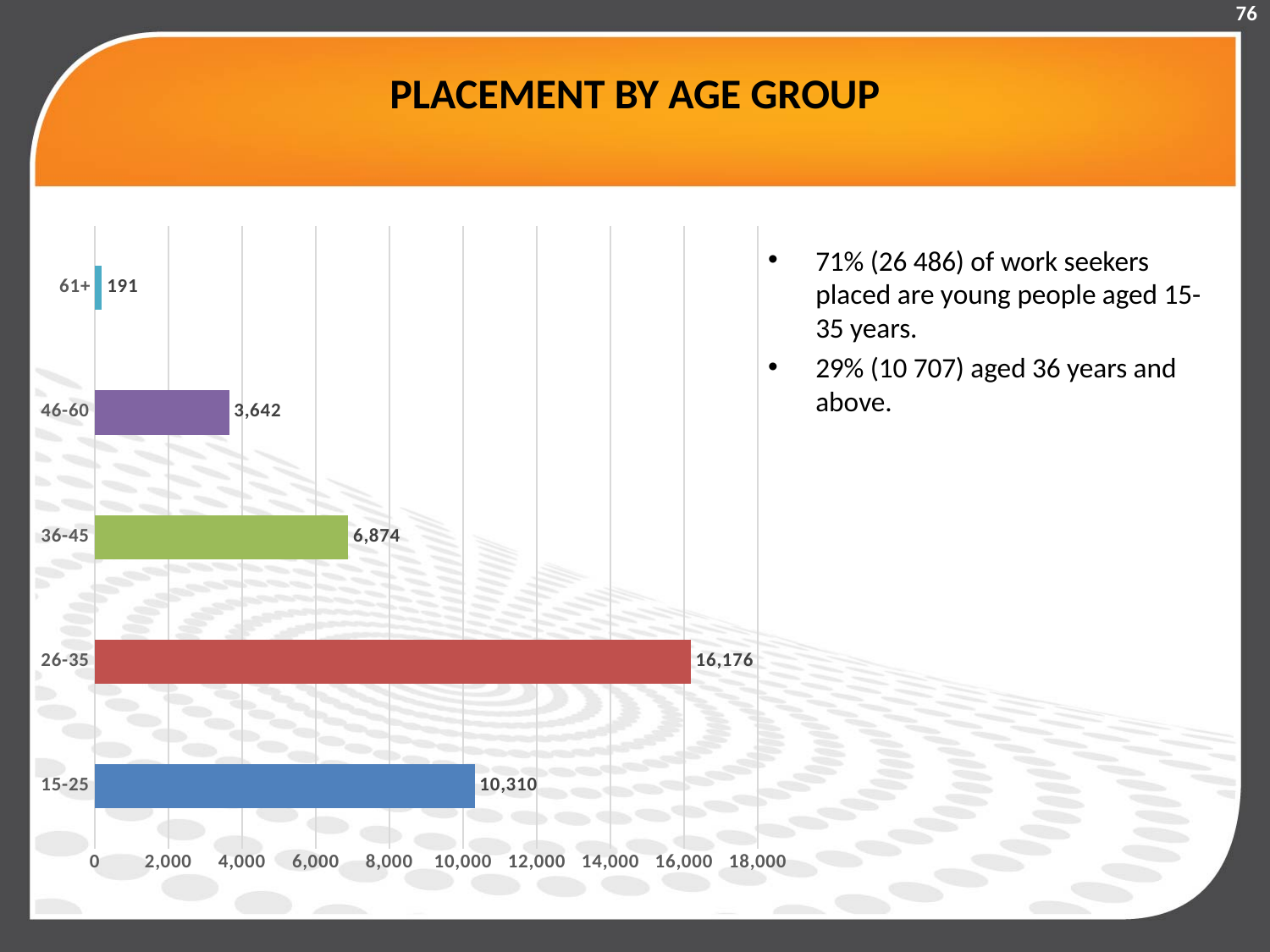
What is the difference between the placement values for the 36-45 and 46-60 age groups? 3,232 Which age group has the lowest placement value? 61+ Which age group has a larger placement value, 15-25 or 36-45? 15-25 How many age groups are shown in the chart? 5 What is the placement value for the 26-35 age group? 16,176 What kind of chart is shown on the slide? bar chart What is the title of the slide containing the chart? PLACEMENT BY AGE GROUP What is the difference between the placement values for the 26-35 and 15-25 age groups? 5,866 What is the placement value for the 46-60 age group? 3,642 Is the placement value for the 15-25 age group greater or less than 10,000? greater Which age group has the highest placement value? 26-35 What is the placement value for the 61+ age group? 191